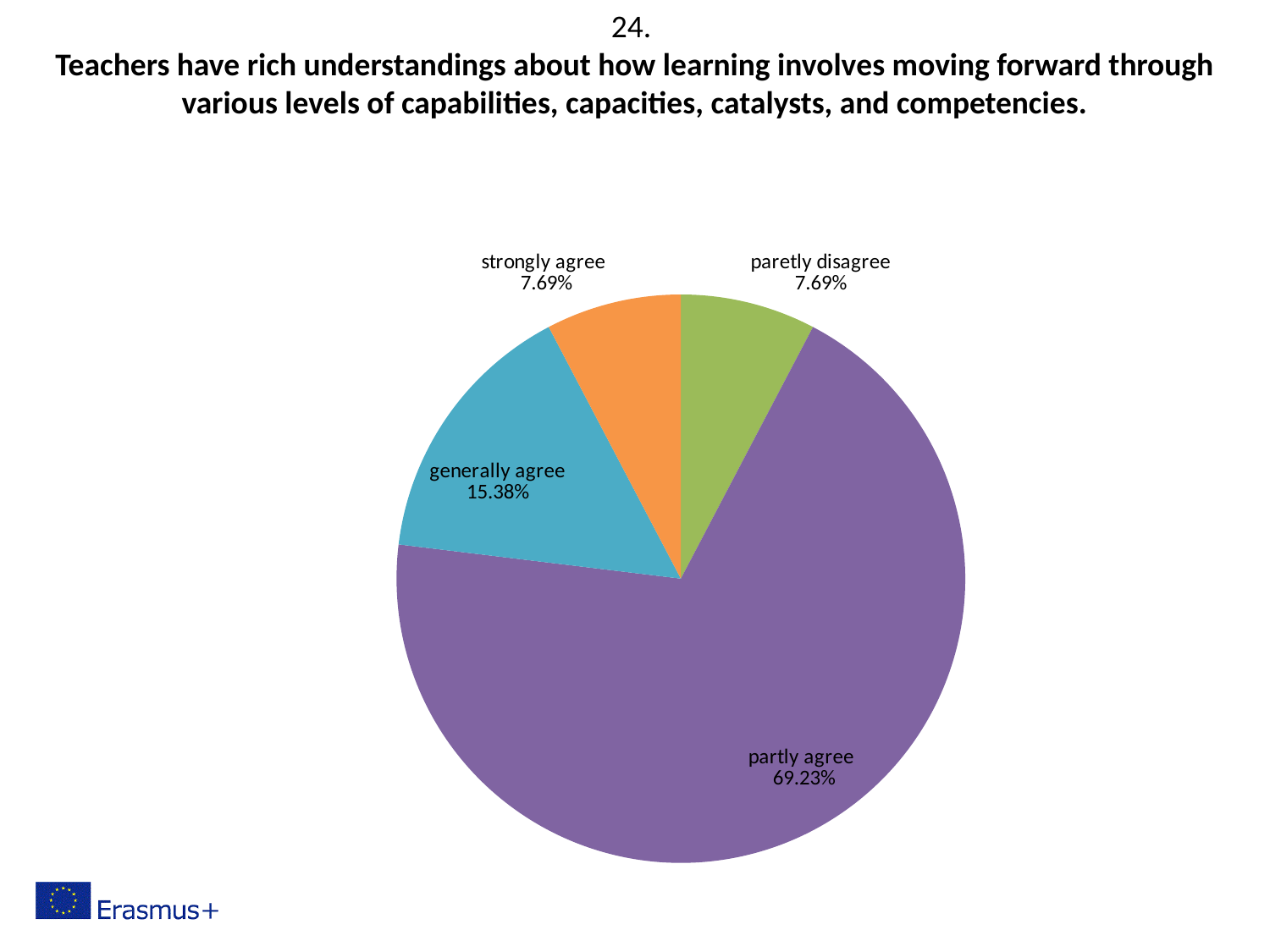
What colour is the "partly agree" slice? purple What share of the pie is labelled "strongly agree"? 7.69% What kind of chart is shown on the slide? pie chart Which slice of the pie is the largest? partly agree What is the combined share of the "strongly agree" and "generally agree" slices? 23.07% How many slices does the pie chart have? 4 What share of the pie is labelled "paretly disagree"? 7.69% Which is larger, the "generally agree" slice or the "strongly agree" slice? generally agree What colour is the "strongly agree" slice? orange What is the difference in percentage points between the "partly agree" and "generally agree" slices? 53.85 What share of the pie is labelled "partly agree"? 69.23% What share of the pie is labelled "generally agree"? 15.38%